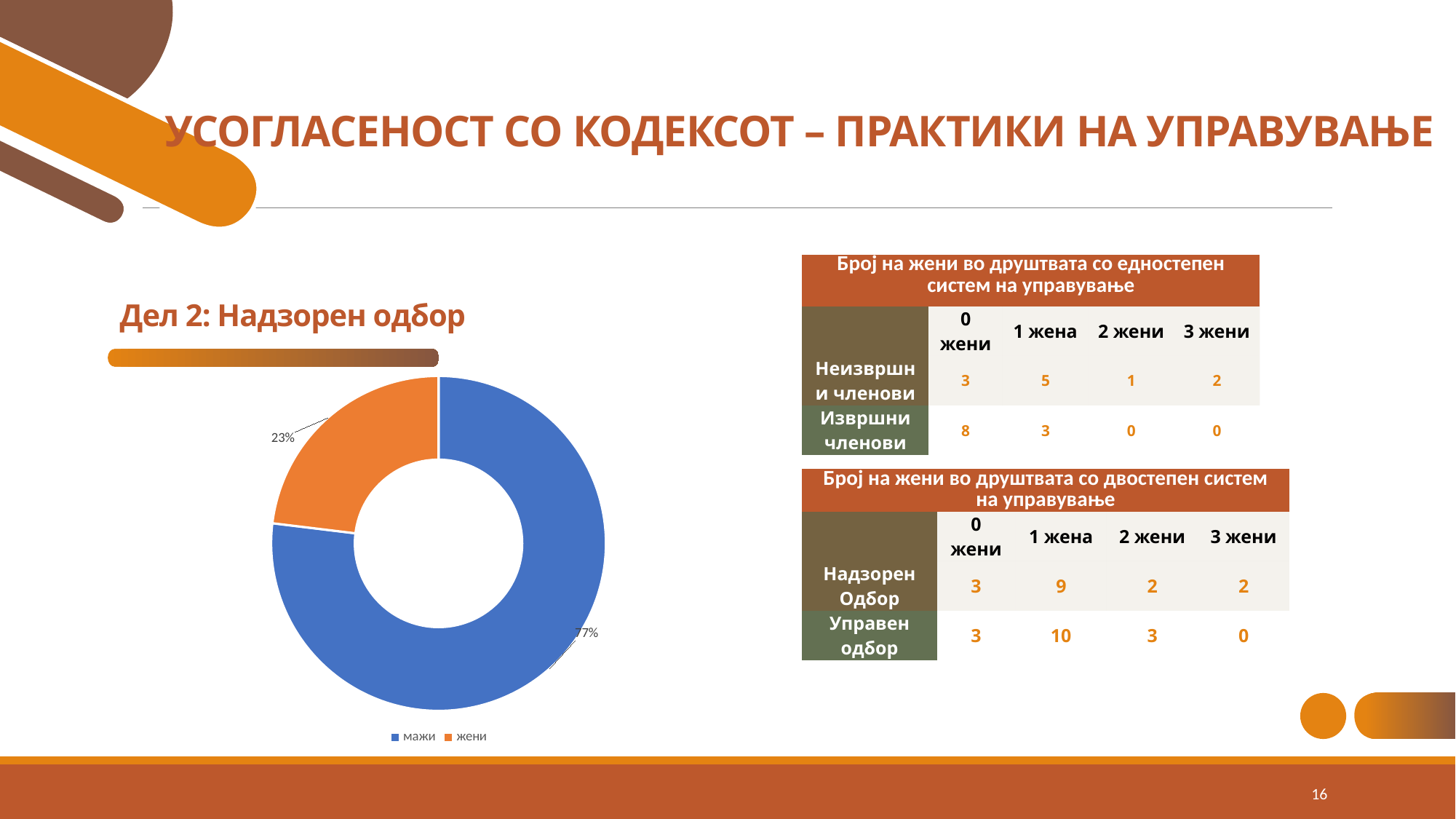
What type of chart is shown under "Дел 2: Надзорен одбор"? Doughnut chart Which category has the largest share in the doughnut chart? мажи How many entries does the legend of the doughnut chart list? 2 What colour is the "мажи" slice in the doughnut chart? Blue Which category has the smallest share in the doughnut chart? жени In the doughnut chart, which is larger: the share for "мажи" or the share for "жени"? мажи What colour is the "жени" slice in the doughnut chart? Orange What is the difference in percentage points between the "мажи" and "жени" slices in the doughnut chart? 54 percentage points What is the combined share of the "мажи" and "жени" slices in the doughnut chart? 100% What percentage does the "жени" slice show in the doughnut chart? 23% How many slices does the doughnut chart have? 2 What percentage does the "мажи" slice show in the doughnut chart? 77%